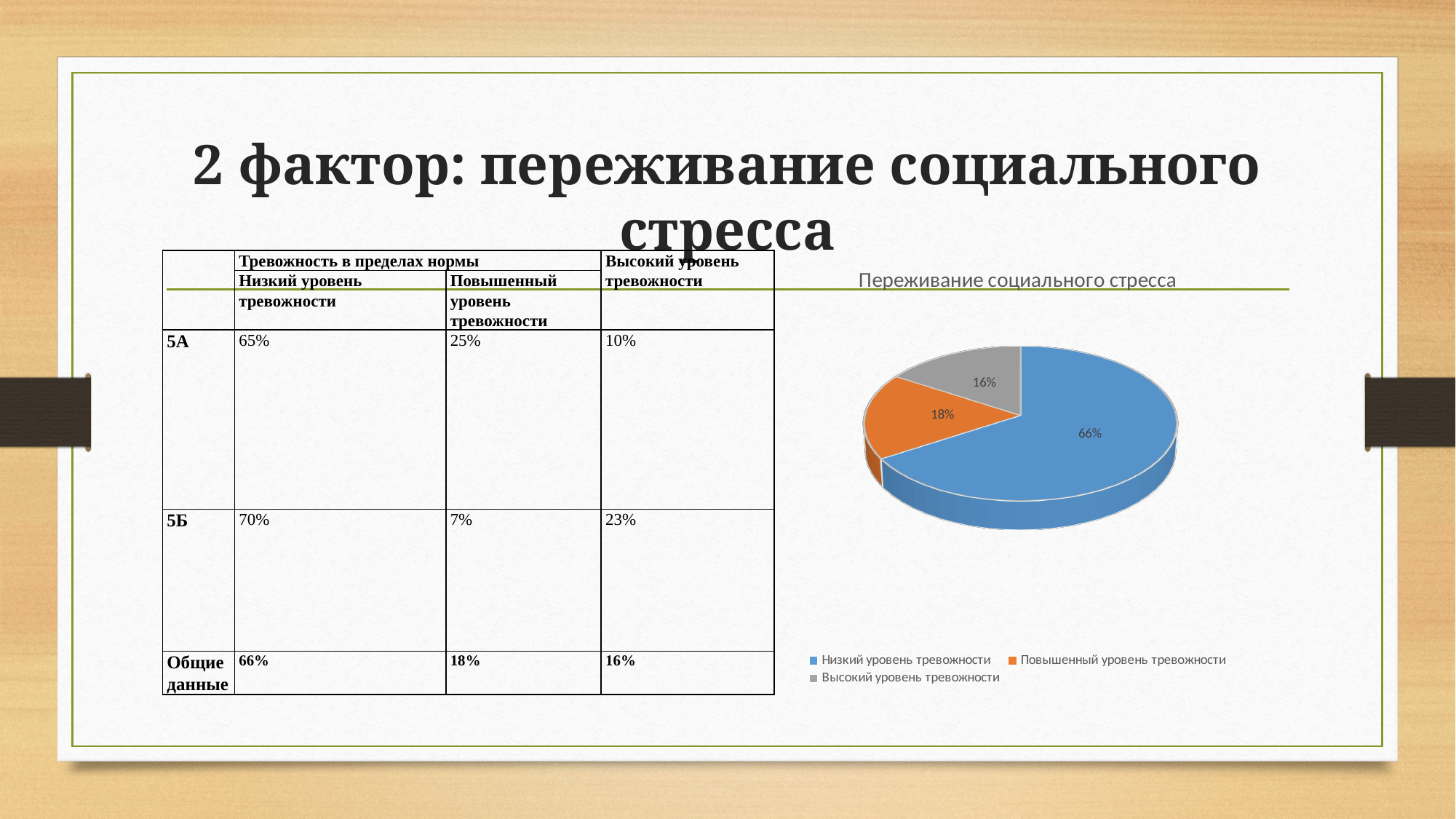
What share of the pie does "Повышенный уровень тревожности" take? 18% What share of the pie does "Высокий уровень тревожности" take? 16% How many entries does the legend list? 3 What is the title of the chart? Переживание социального стресса What colour is the slice for "Низкий уровень тревожности"? blue What share of the pie does "Низкий уровень тревожности" take? 66% How many slices does the pie chart have? 3 Which category has the largest slice of the pie? Низкий уровень тревожности What type of chart is shown on the slide? pie chart Which is larger: the slice for "Повышенный уровень тревожности" or the slice for "Высокий уровень тревожности"? Повышенный уровень тревожности Which category has the smallest slice of the pie? Высокий уровень тревожности What is the difference between the shares of "Низкий уровень тревожности" and "Повышенный уровень тревожности"? 48%